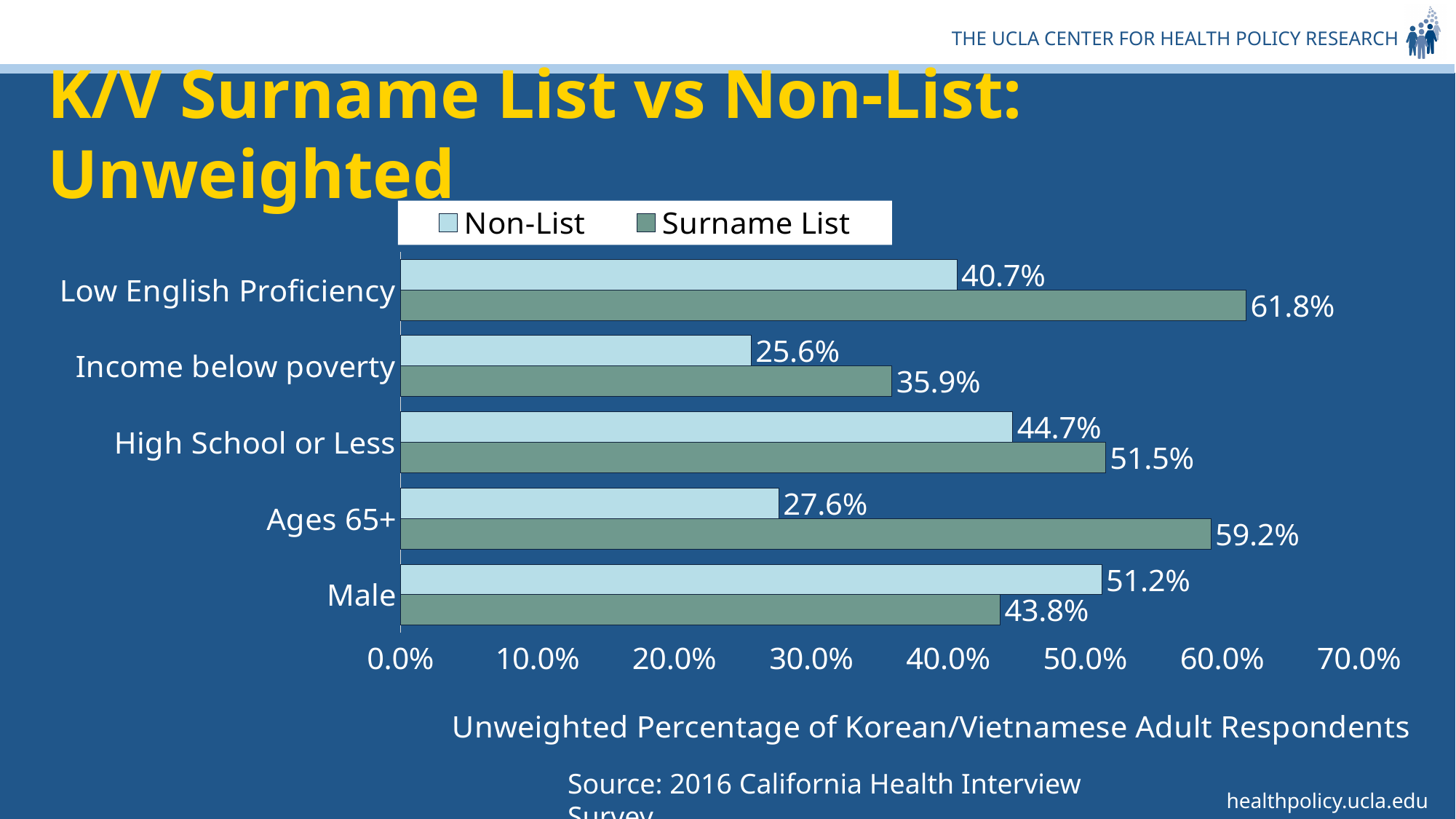
Which category has the lowest Non-List value? Income below poverty What is the Surname List value for Low English Proficiency? 61.8% What kind of chart is shown on the slide? Bar chart Which category has the highest Surname List value? Low English Proficiency What is the difference between the Surname List and Non-List values for Ages 65+? 31.6% What is the Surname List value for Ages 65+? 59.2% What is the Non-List value for Male? 51.2% What is the Non-List value for Income below poverty? 25.6% For Male, which is larger: the Non-List value or the Surname List value? Non-List How many categories are shown on the chart? 5 How many series does the legend list? 2 What is the x-axis label of the chart? Unweighted Percentage of Korean/Vietnamese Adult Respondents